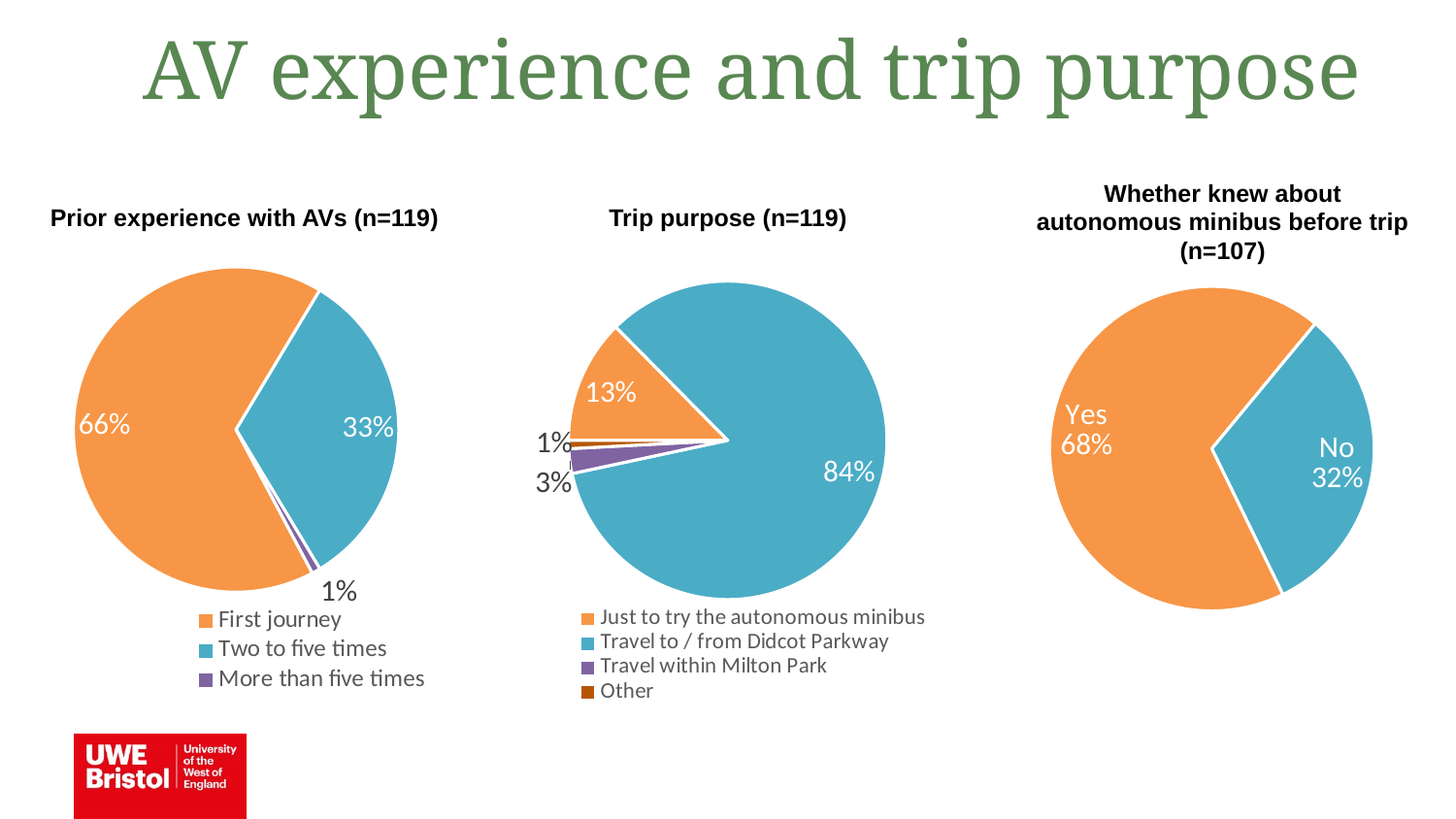
In the 'Whether knew about autonomous minibus before trip (n=107)' pie chart, which is larger, 'Yes' or 'No'? Yes In the 'Prior experience with AVs (n=119)' pie chart, which category has the smallest slice? More than five times In the 'Whether knew about autonomous minibus before trip (n=107)' pie chart, what share answered 'No'? 32% In the 'Prior experience with AVs (n=119)' pie chart, how many categories does the legend list? 3 In the 'Trip purpose (n=119)' pie chart, which category has the largest slice? Travel to / from Didcot Parkway In the 'Prior experience with AVs (n=119)' pie chart, what share is labelled for 'Two to five times'? 33% What type of chart is used for 'Trip purpose (n=119)'? Pie chart In the 'Trip purpose (n=119)' pie chart, how many categories does the legend list? 4 In the 'Trip purpose (n=119)' pie chart, what is the difference in percentage points between 'Travel to / from Didcot Parkway' and 'Just to try the autonomous minibus'? 71 percentage points In the 'Trip purpose (n=119)' pie chart, what share is labelled for 'Travel to / from Didcot Parkway'? 84%